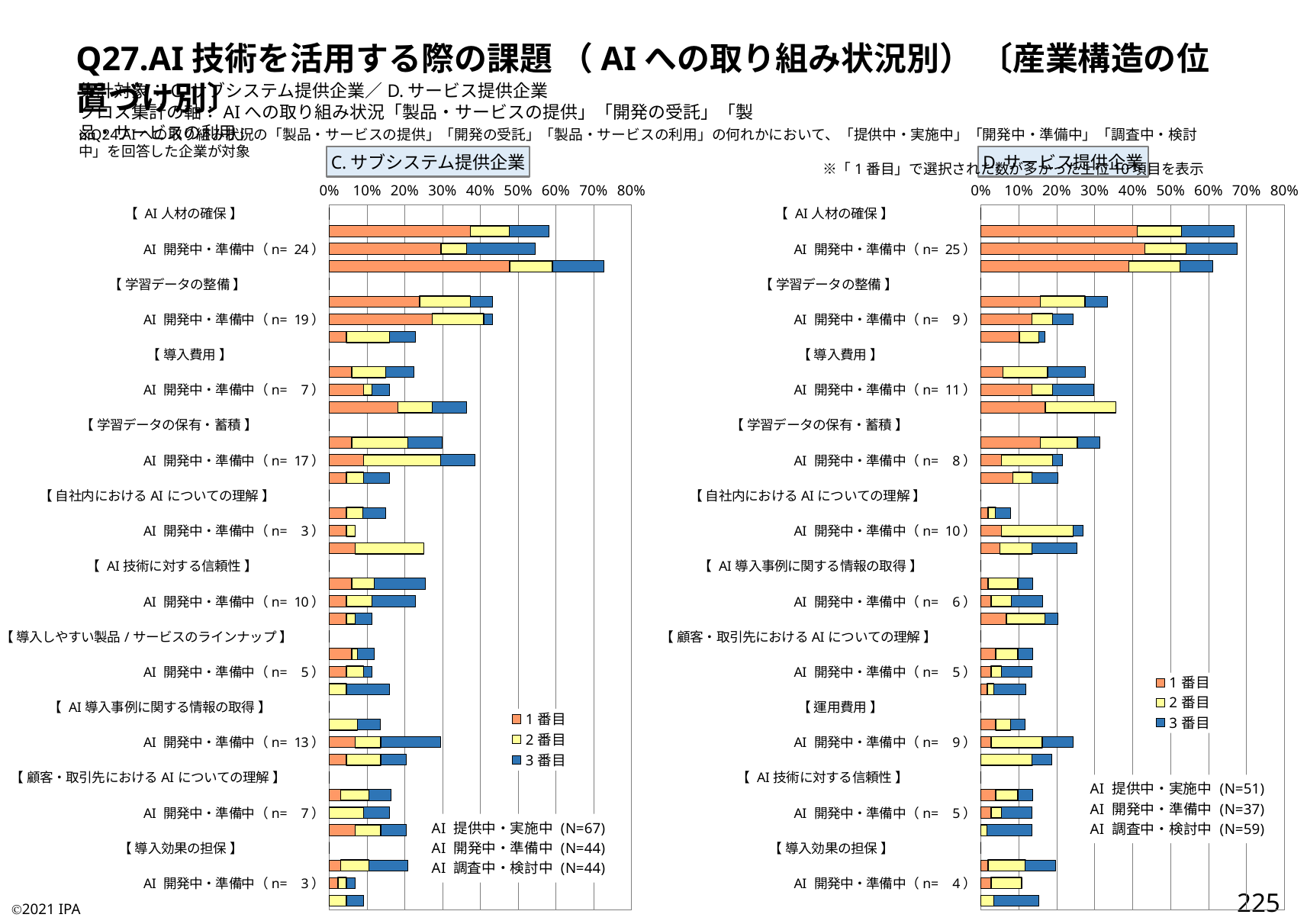
In the left chart titled C. サブシステム提供企業, is the total bar for 【AI人材の確保】 for the AI 調査中・検討中 group greater or less than 60%? greater In the left chart titled C. サブシステム提供企業, what are the legend entries? 1番目, 2番目, 3番目 In the right chart titled D. サービス提供企業, what is the sample size (N) shown for the AI 提供中・実施中 group? N=51 In the right chart titled D. サービス提供企業, how many series does the legend list? 3 In the left chart titled C. サブシステム提供企業, is the total bar for 【学習データの整備】 for the AI 調査中・検討中 group (third bar) greater or less than 30%? less What kind of chart is the left chart titled C. サブシステム提供企業? Stacked bar chart In the left chart titled C. サブシステム提供企業, which challenge category has the longest total bar for the AI 提供中・実施中 group? AI人材の確保 In the right chart titled D. サービス提供企業, is the total bar for 【自社内におけるAIについての理解】 for the AI 提供中・実施中 group (first bar) greater or less than 10%? less In the right chart titled D. サービス提供企業, which is larger for the AI 開発中・準備中 group: the total bar for 【AI人材の確保】 or for 【導入効果の担保】? AI人材の確保 How many challenge categories (bracketed headings) are shown in the left chart titled C. サブシステム提供企業? 10